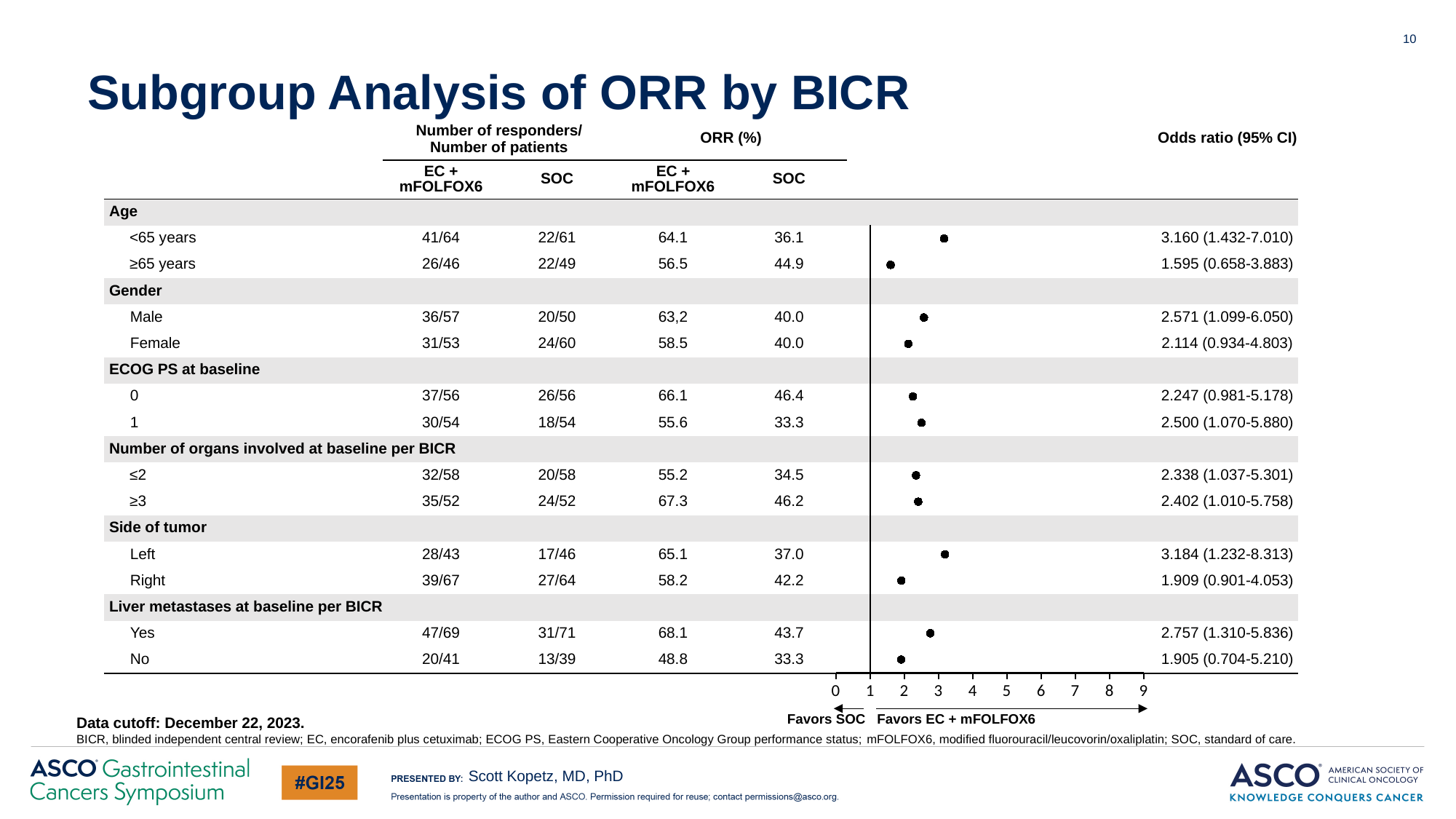
What is the odds ratio (95% CI) for patients with liver metastases at baseline (Yes)? 2.757 (1.310-5.836) What kind of chart is shown on the slide? Forest plot What is the odds ratio for the Left side of tumor subgroup? 3.184 Which subgroup has the lowest odds ratio in the forest plot? ≥65 years Which has the larger odds ratio, the Male or the Female subgroup? Male According to the axis labels, which direction of the forest plot favors EC + mFOLFOX6? Right (higher odds ratios) Is the odds ratio for the ≥65 years subgroup greater or less than 2? less How many subgroup points are plotted in the forest plot? 12 What is the difference between the odds ratios for the Left and Right side of tumor subgroups? 1.275 What is the odds ratio (95% CI) for the <65 years subgroup? 3.160 (1.432-7.010) What is the maximum value shown on the x axis of the forest plot? 9 Which subgroup has the highest odds ratio in the forest plot? Left (side of tumor)